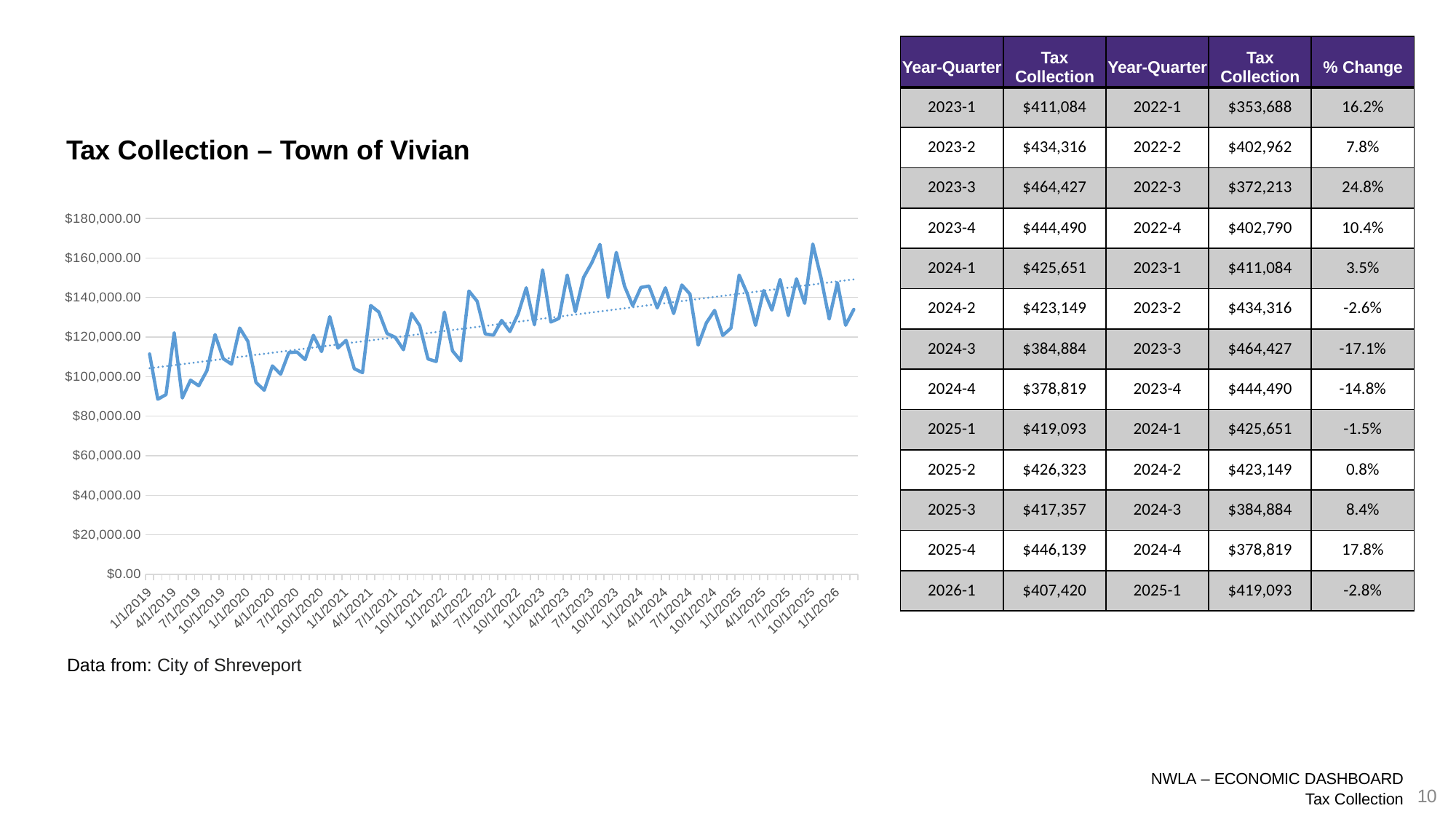
What kind of chart is shown on the slide? Line chart In the Tax Collection – Town of Vivian chart, is the peak value around 7/1/2023 greater or less than $160,000.00? greater In the Tax Collection – Town of Vivian chart, is the value at 1/1/2026 greater or less than $120,000.00? greater In the Tax Collection – Town of Vivian chart, is the value at 1/1/2019 greater or less than $100,000.00? greater What is the highest value shown on the y axis of the Tax Collection – Town of Vivian chart? $180,000.00 How many date labels are shown along the x axis of the Tax Collection – Town of Vivian chart? 29 What is the title of the chart on the slide? Tax Collection – Town of Vivian In the Tax Collection – Town of Vivian chart, is the value at 1/1/2019 greater or less than the value at 1/1/2026? less Overall, do the values in the Tax Collection – Town of Vivian chart rise or fall from 1/1/2019 to 1/1/2026? Rise